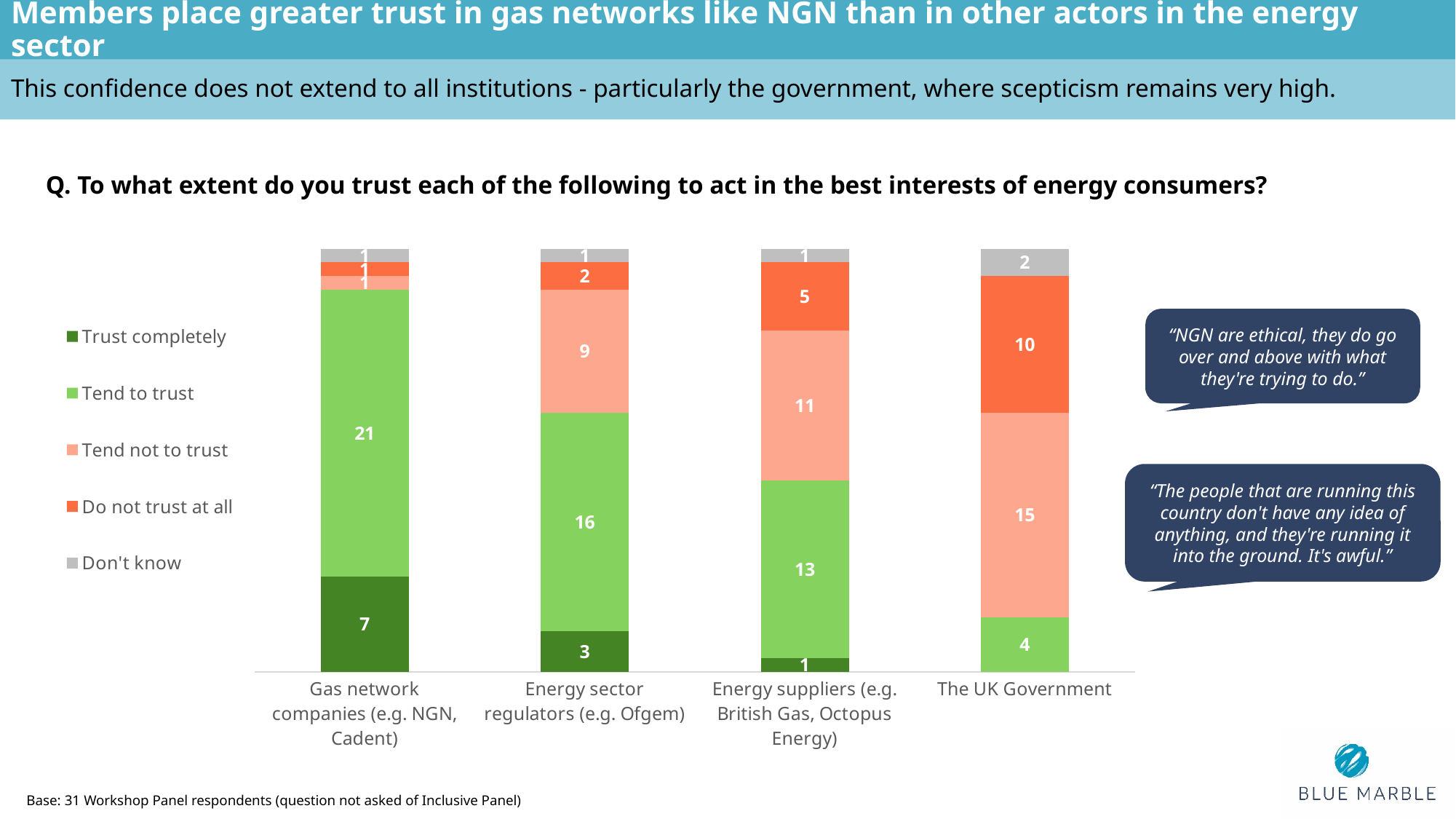
What is the 'Tend to trust' value for Gas network companies (e.g. NGN, Cadent)? 21 How many series does the legend list? 5 Which legend entry is shown in dark green? Trust completely What is the difference between the 'Tend to trust' values for Gas network companies and Energy sector regulators? 5 How many categories (institutions) are shown on the x axis? 4 What is the total of the stacked bar for Energy sector regulators (e.g. Ofgem)? 31 What is the 'Tend not to trust' value for The UK Government? 15 Which category has the highest 'Trust completely' value? Gas network companies (e.g. NGN, Cadent) Which is larger: the 'Do not trust at all' value for The UK Government or for Energy sector regulators? The UK Government Which category has the lowest 'Tend to trust' value? The UK Government What kind of chart is shown on the slide? Stacked bar chart What is the 'Do not trust at all' value for Energy suppliers (e.g. British Gas, Octopus Energy)? 5